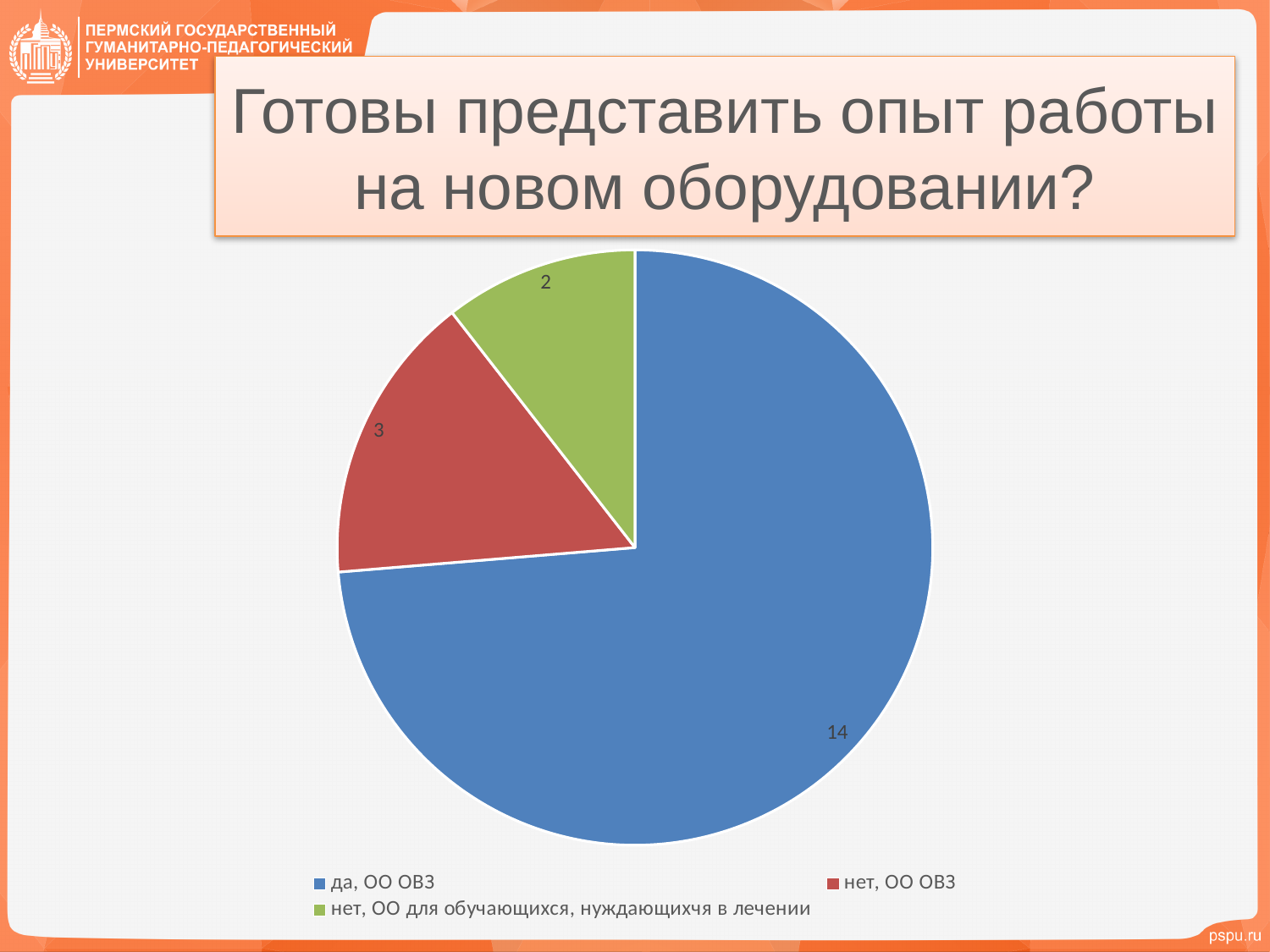
What colour is the slice for "нет, ОО ОВЗ"? Red What is the value for the slice "да, ОО ОВЗ"? 14 What is the difference between the values for "да, ОО ОВЗ" and "нет, ОО ОВЗ"? 11 What is the value for the slice "нет, ОО ОВЗ"? 3 Which category has the smallest slice of the pie? нет, ОО для обучающихся, нуждающихчя в лечении What share of the total does the slice "да, ОО ОВЗ" represent? 14 out of 19 What is the total of all the values shown in the pie chart? 19 Which is larger: the value for "нет, ОО ОВЗ" or the value for "нет, ОО для обучающихся, нуждающихчя в лечении"? нет, ОО ОВЗ How many slices does the pie chart have? 3 What is the value for the slice "нет, ОО для обучающихся, нуждающихчя в лечении"? 2 Which category has the largest slice of the pie? да, ОО ОВЗ What type of chart is shown on the slide? Pie chart